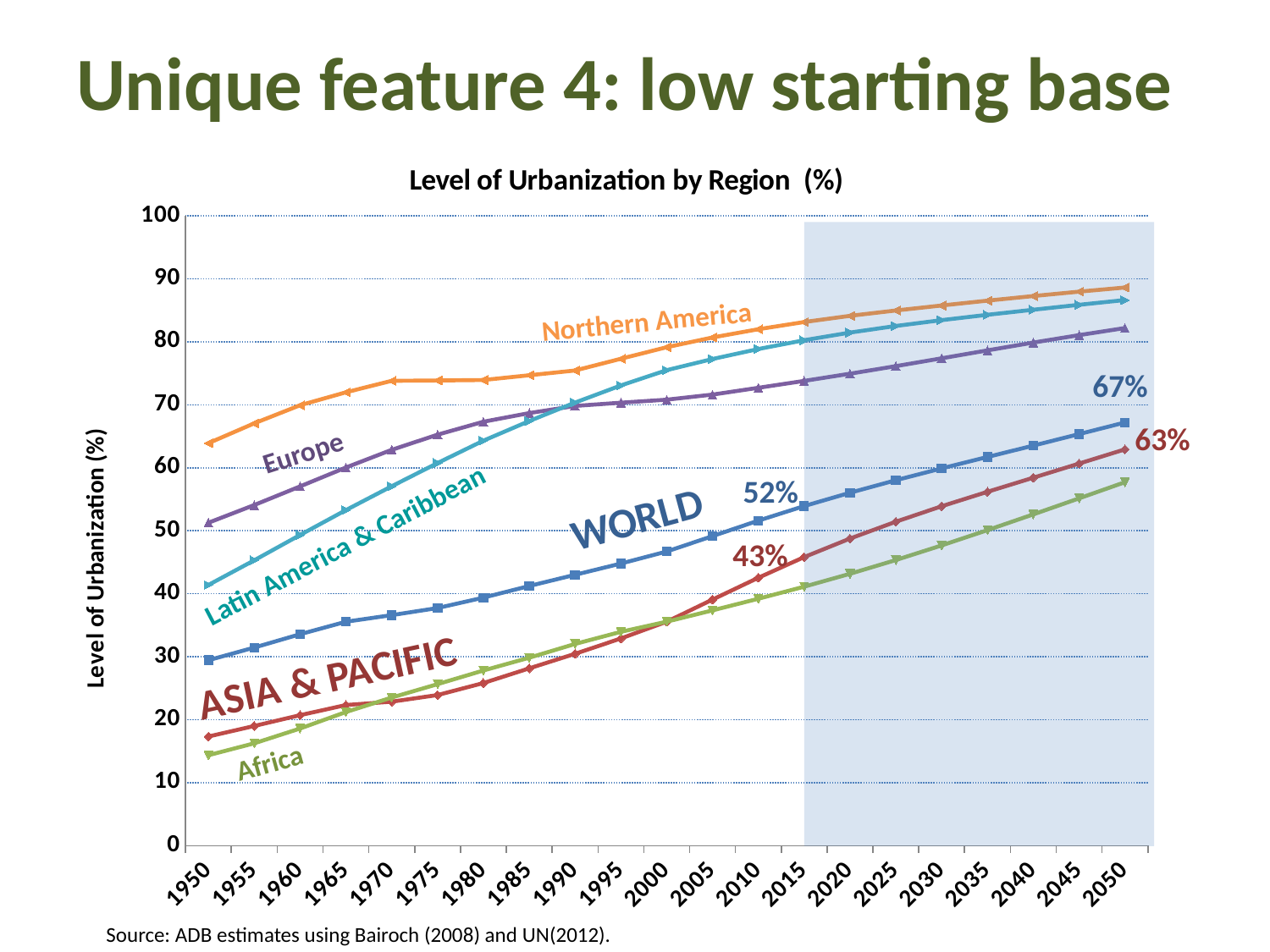
What is the value for ASIA & PACIFIC in 2050? 63% What is the value for WORLD in 2050? 67% Is the value for Northern America in 1950 greater or less than 60? greater Which region has the lowest level of urbanization in 1950? Africa In 2050, which is higher: ASIA & PACIFIC or Africa? ASIA & PACIFIC Which region has the highest level of urbanization in 2050? Northern America How many series (regions) are plotted on the chart? 6 What type of chart is shown? line chart